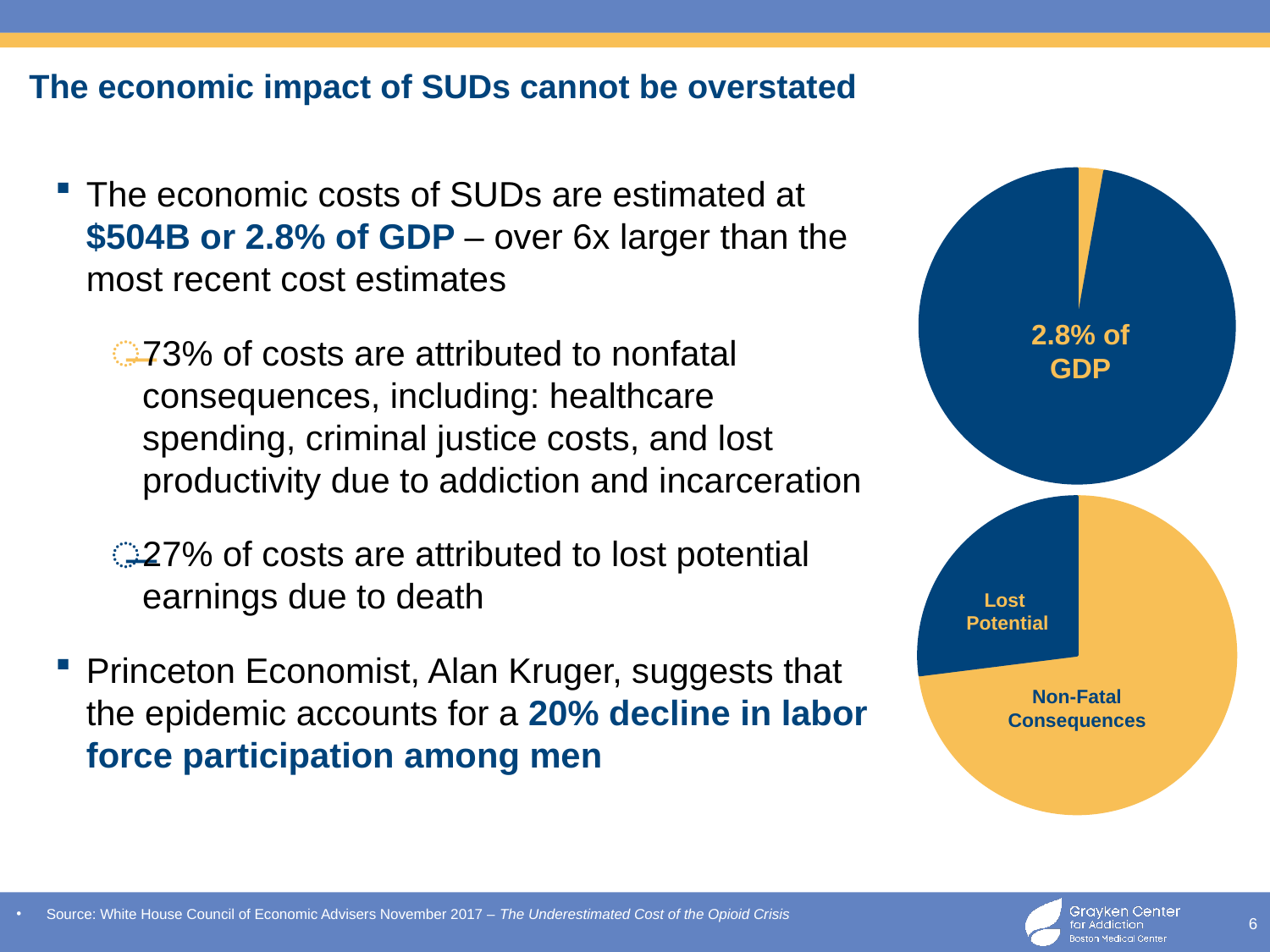
What kind of chart is the bottom chart on the right side of the slide? pie chart In the bottom pie chart, is the Non-Fatal Consequences slice greater or less than 50% of the pie? greater In the bottom pie chart, which slice is the largest? Non-Fatal Consequences In the bottom pie chart, how many slices are there? 2 In the bottom pie chart, which is larger: Lost Potential or Non-Fatal Consequences? Non-Fatal Consequences In the bottom pie chart, what share of costs is attributed to Non-Fatal Consequences? 73% In the bottom pie chart, what share of costs is attributed to Lost Potential? 27% In the bottom pie chart, what colour is the Non-Fatal Consequences slice? yellow What kind of chart is the top chart on the right side of the slide, labelled "2.8% of GDP"? pie chart How many charts are shown on the slide? 2 What text label is printed on the top pie chart? 2.8% of GDP In the bottom pie chart, which slice is the smallest? Lost Potential